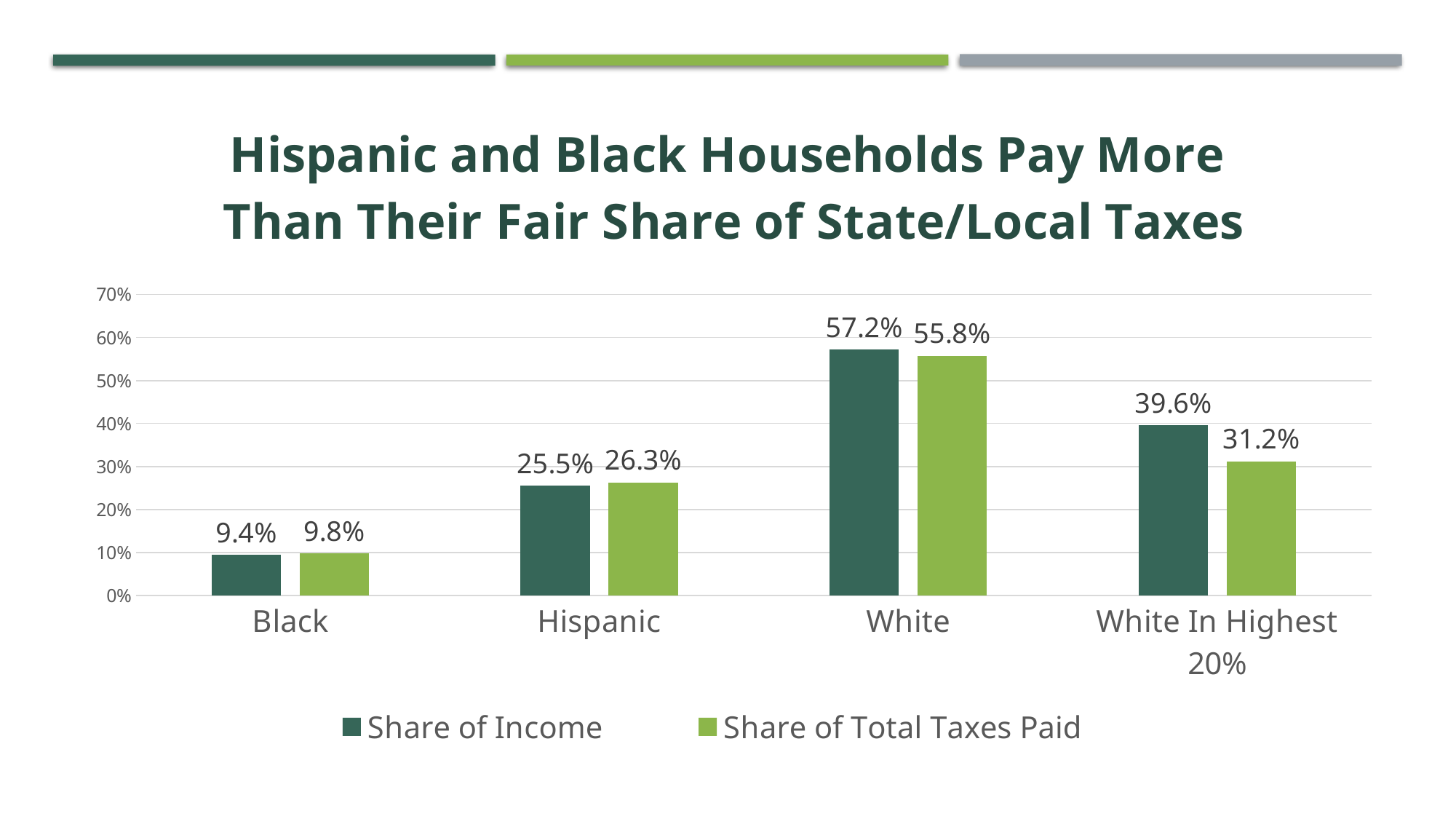
What kind of chart is shown on the slide? Bar chart Is the Share of Income for White households greater or less than 50%? greater What is the difference between Share of Income and Share of Total Taxes Paid for White In Highest 20%? 8.4% How many categories are shown on the x axis? 4 Which category has the lowest Share of Total Taxes Paid? Black How many series does the legend list? 2 What is the Share of Income for Black households? 9.4% Which category has the highest Share of Income? White What is the Share of Total Taxes Paid for White In Highest 20%? 31.2% What is the difference between Share of Income and Share of Total Taxes Paid for White households? 1.4% What is the Share of Total Taxes Paid for Hispanic households? 26.3% For Hispanic households, which is larger: Share of Income or Share of Total Taxes Paid? Share of Total Taxes Paid